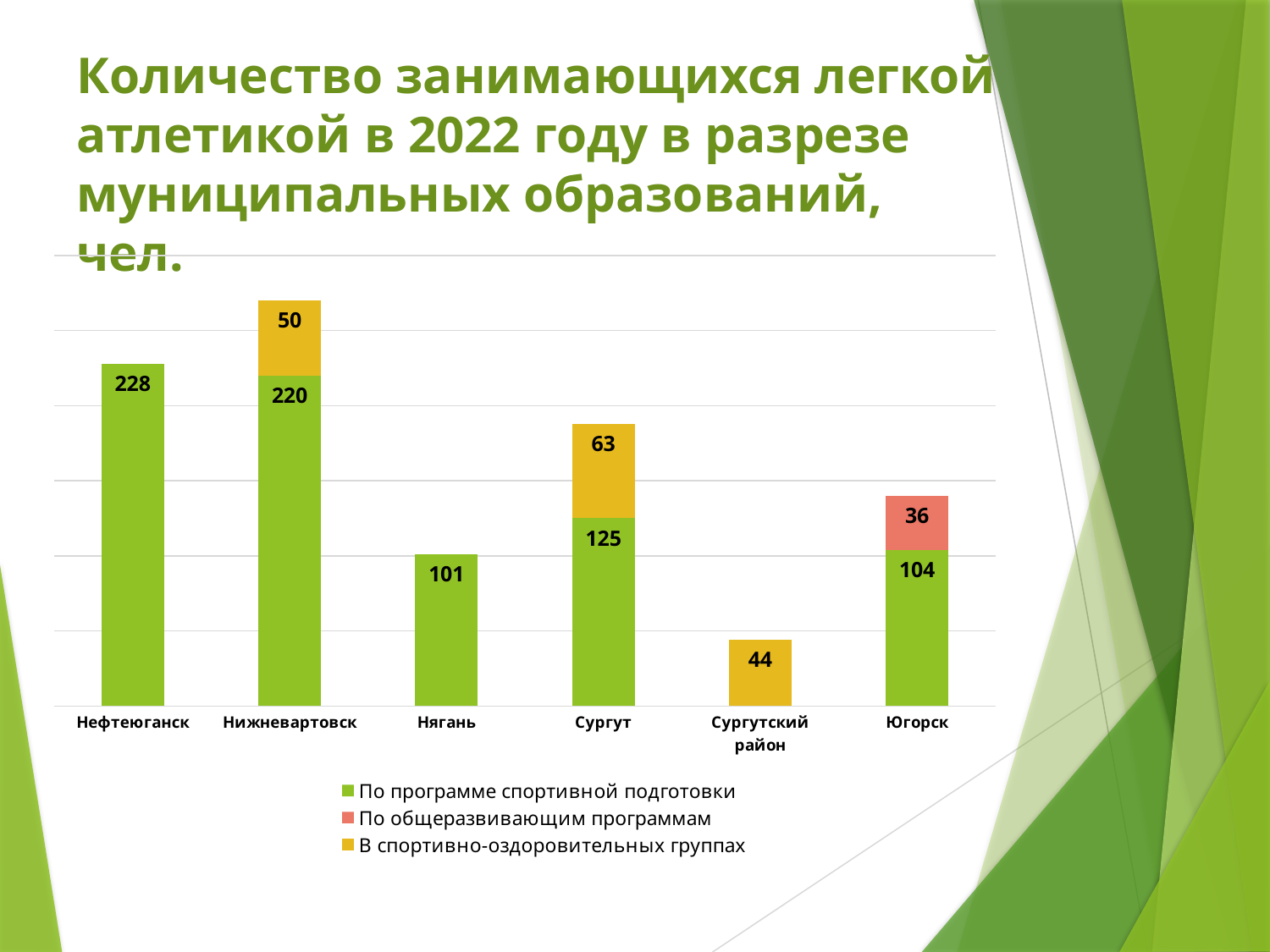
What is the value for Югорск in the series 'По общеразвивающим программам'? 36 How many series does the legend list? 3 What is the value for Нижневартовск in the series 'В спортивно-оздоровительных группах'? 50 What is the difference between the 'По программе спортивной подготовки' values for Нефтеюганск and Нягань? 127 What is the value for Сургутский район in the series 'В спортивно-оздоровительных группах'? 44 How many categories are shown on the x axis? 6 What is the value for Нефтеюганск in the series 'По программе спортивной подготовки'? 228 What is the total of the stacked bar for Нижневартовск? 270 Which category has the highest value in the series 'По программе спортивной подготовки'? Нефтеюганск Which category has the lowest total stacked bar? Сургутский район What is the total of the stacked bar for Сургут? 188 Which is larger: the 'В спортивно-оздоровительных группах' value for Сургут or for Нижневартовск? Сургут